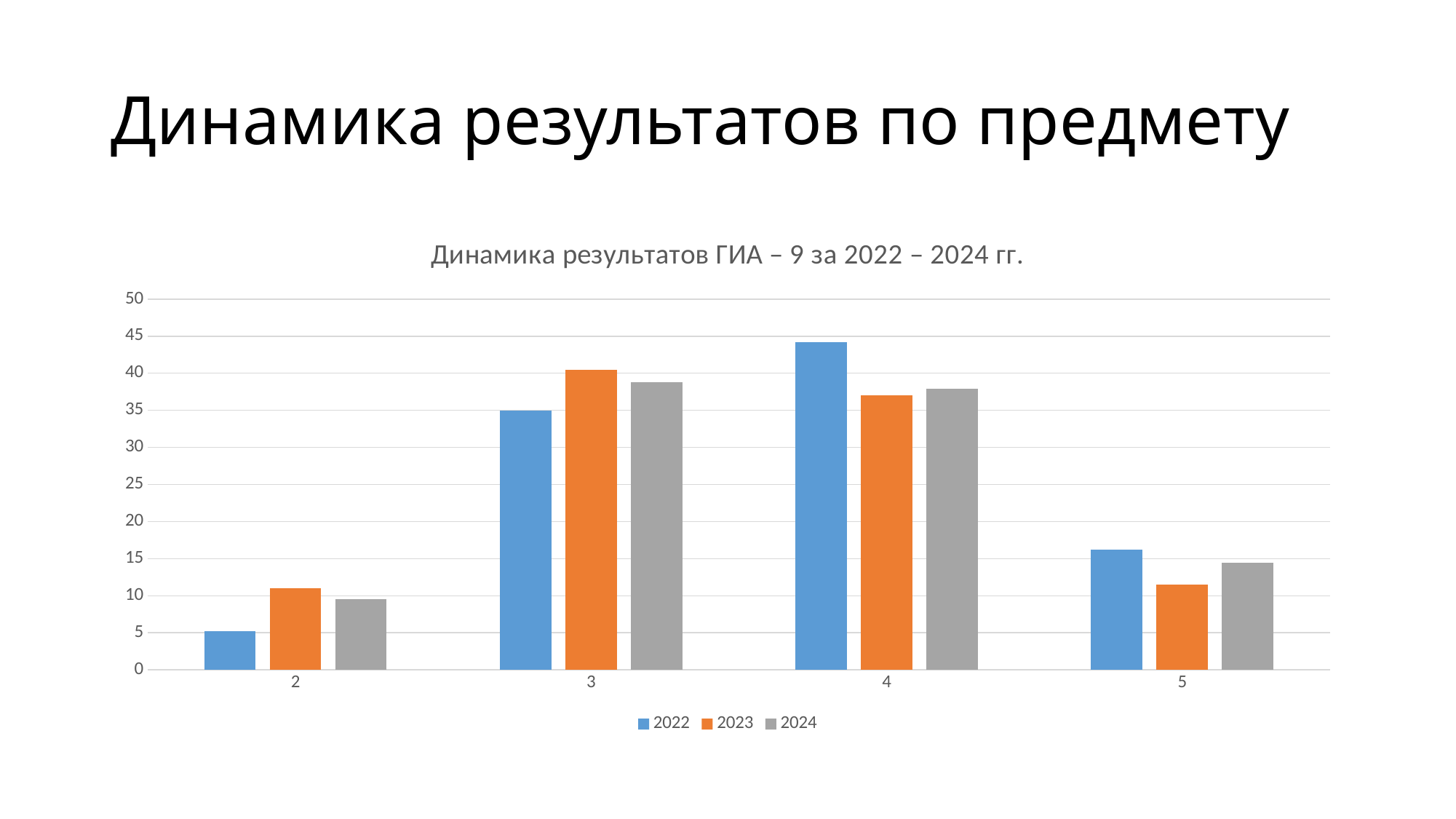
For the 2022 series, which category has the lowest bar? 2 For the 2023 series, which category has the highest bar? 3 How many series does the legend list? 3 What kind of chart is shown on the slide? bar chart In category 2, which is larger: the 2022 value or the 2023 value? 2023 What is the title of the chart? Динамика результатов ГИА – 9 за 2022 – 2024 гг. Is the value for 2023 in category 5 greater or less than 15? less In category 4, which is larger: the 2022 value or the 2023 value? 2022 Is the value for 2022 in category 4 greater or less than 40? greater How many categories are shown on the x axis? 4 For the 2022 series, which category has the highest bar? 4